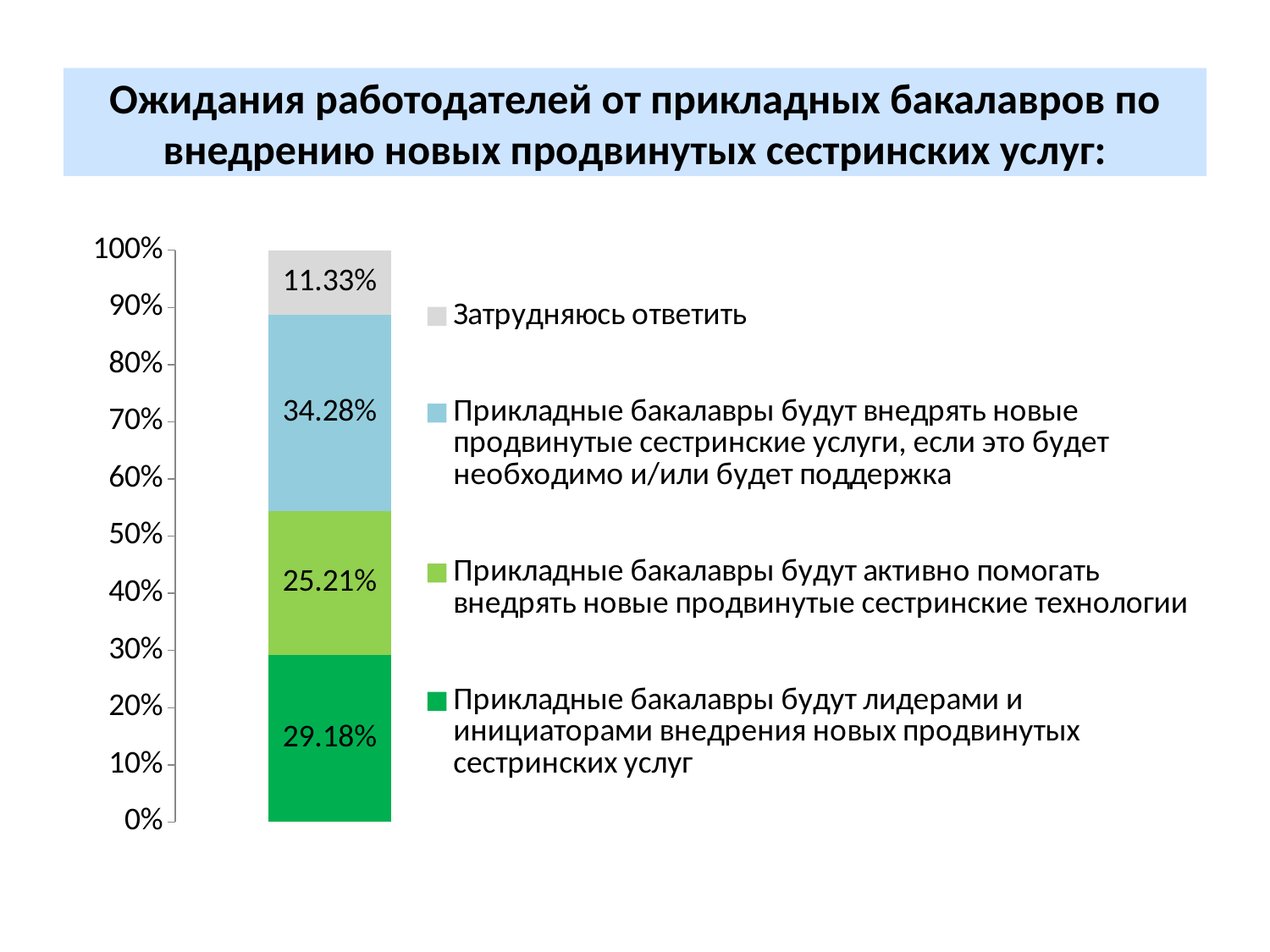
What is the value for "Прикладные бакалавры будут внедрять новые продвинутые сестринские услуги, если это будет необходимо и/или будет поддержка"? 34.28% What is the difference between the largest segment (34.28%) and the "Затрудняюсь ответить" segment (11.33%)? 22.95% Which legend category has the smallest share in the bar? Затрудняюсь ответить Which is larger: the share for "будут лидерами и инициаторами" or the share for "будут активно помогать"? будут лидерами и инициаторами (29.18%) What is the value for "Прикладные бакалавры будут активно помогать внедрять новые продвинутые сестринские технологии"? 25.21% What is the difference between the "лидерами и инициаторами" segment (29.18%) and the "активно помогать" segment (25.21%)? 3.97% Which legend category has the largest share in the bar? Прикладные бакалавры будут внедрять новые продвинутые сестринские услуги, если это будет необходимо и/или будет поддержка What type of chart is shown on the slide? Stacked bar chart What is the value of the segment "Затрудняюсь ответить"? 11.33% How many series does the legend list? 4 What share of employers expect that applied bachelors will be leaders and initiators of introducing new advanced nursing services ("Прикладные бакалавры будут лидерами и инициаторами внедрения новых продвинутых сестринских услуг")? 29.18% What colour is the segment for "Затрудняюсь ответить"? Grey